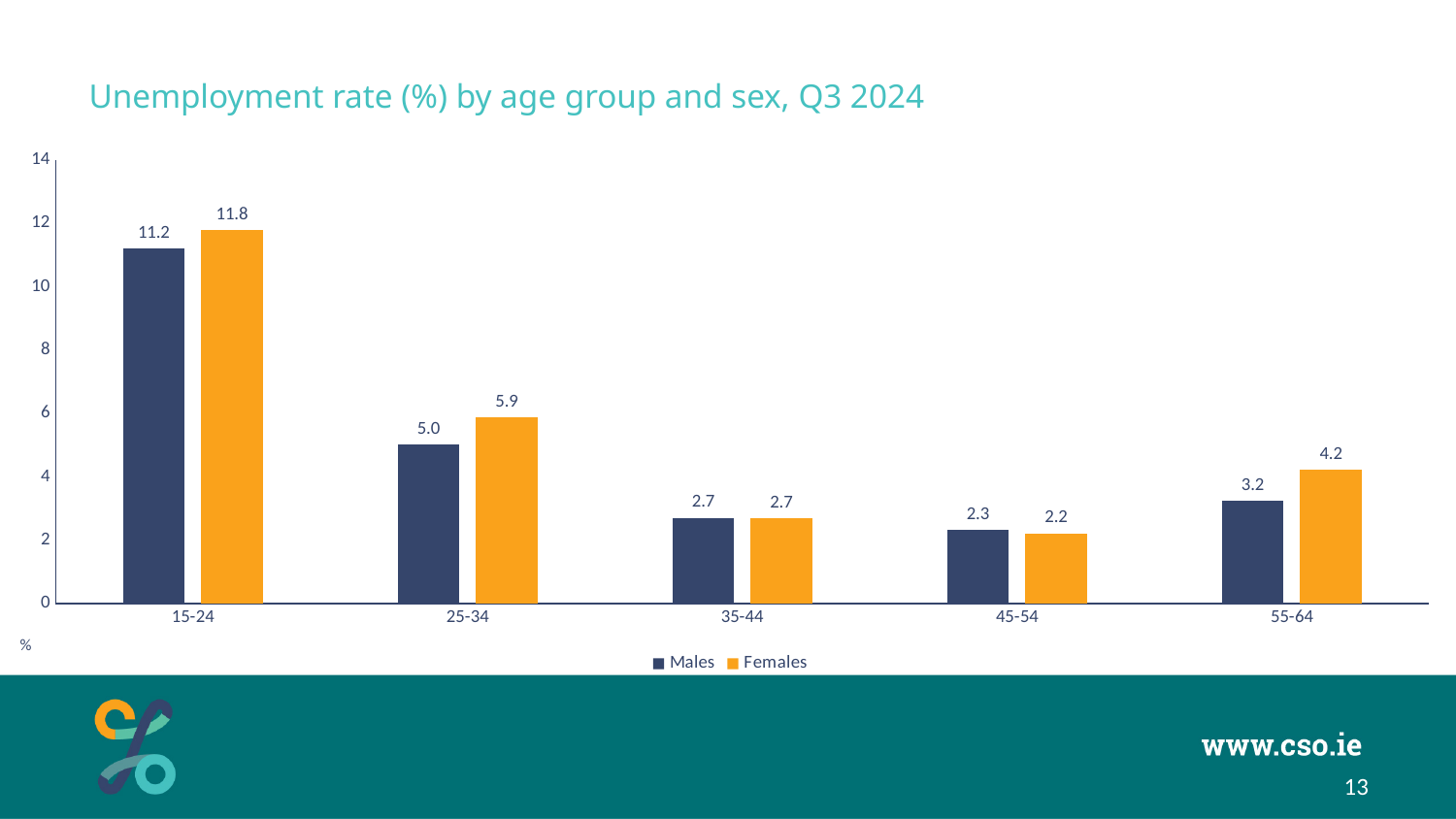
How many series does the legend list? 2 Which age group has the highest unemployment rate for females? 15-24 Is the unemployment rate for males aged 15-24 greater or less than 10? greater What kind of chart is shown on the slide? Bar chart What is the unemployment rate for females aged 55-64? 4.2 Which is larger, the male or the female unemployment rate for the 45-54 age group? Males What is the difference between the female and male unemployment rates for the 25-34 age group? 0.9 What is the unemployment rate for males aged 15-24? 11.2 How many age groups are shown on the x axis? 5 What is the unemployment rate for females aged 25-34? 5.9 What is the title of the chart? Unemployment rate (%) by age group and sex, Q3 2024 Which age group has the lowest unemployment rate for males? 45-54